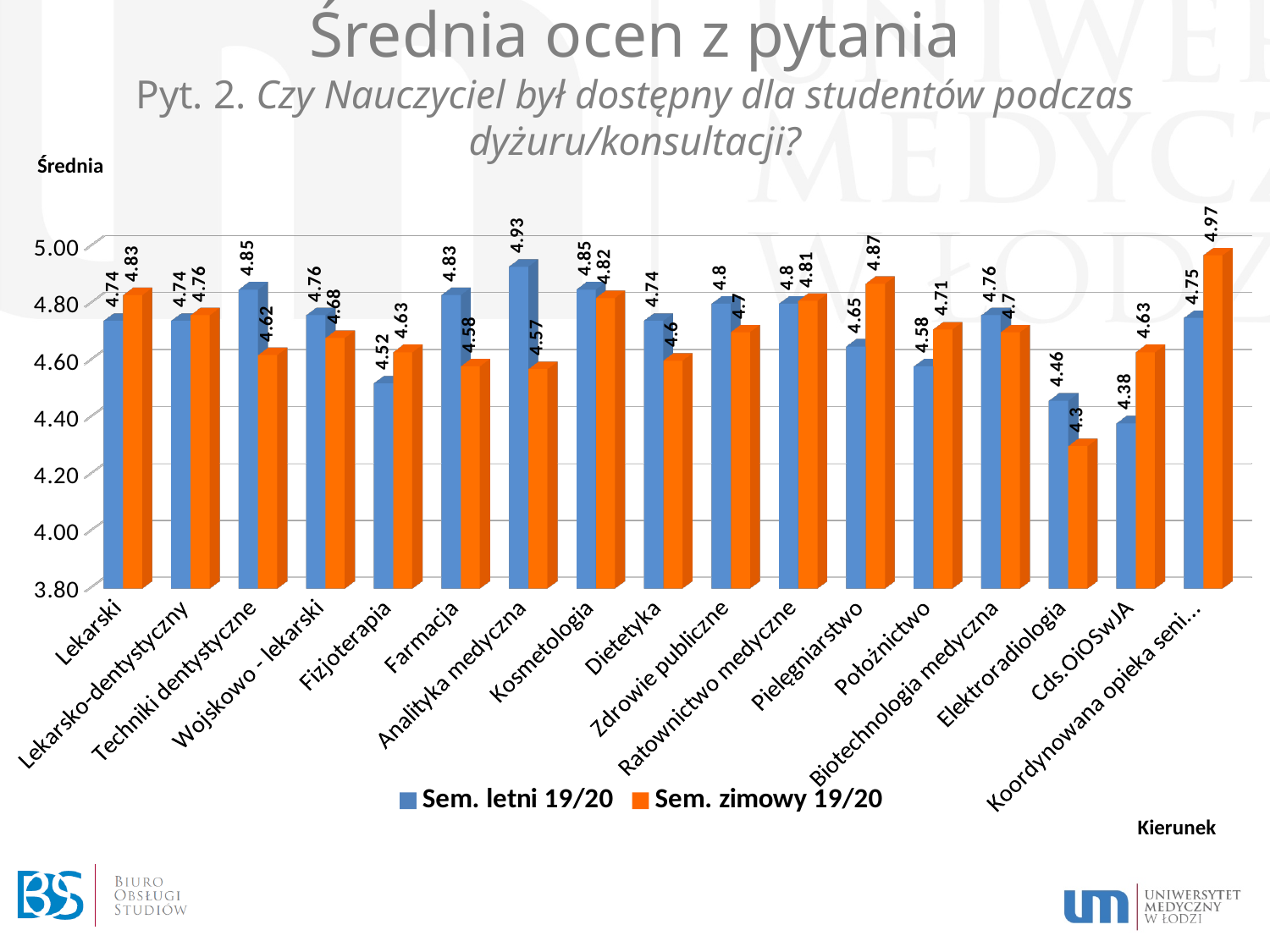
What is the value for Pielęgniarstwo in the Sem. zimowy 19/20 series? 4.87 Which category has the lowest value in the Sem. zimowy 19/20 series? Elektroradiologia What kind of chart is shown on the slide? Bar chart What is the value for Elektroradiologia in the Sem. zimowy 19/20 series? 4.3 Which category has the highest value in the Sem. letni 19/20 series? Analityka medyczna How many categories (kierunki) are shown on the x axis? 17 What is the value for Analityka medyczna in the Sem. letni 19/20 series? 4.93 For Cds.OiOSwJA, which series has the larger value: Sem. letni 19/20 or Sem. zimowy 19/20? Sem. zimowy 19/20 For Farmacja, which series has the larger value: Sem. letni 19/20 or Sem. zimowy 19/20? Sem. letni 19/20 How many series does the legend list? 2 Which category has the lowest value in the Sem. letni 19/20 series? Cds.OiOSwJA What is the difference between the Sem. letni 19/20 and Sem. zimowy 19/20 values for Analityka medyczna? 0.36